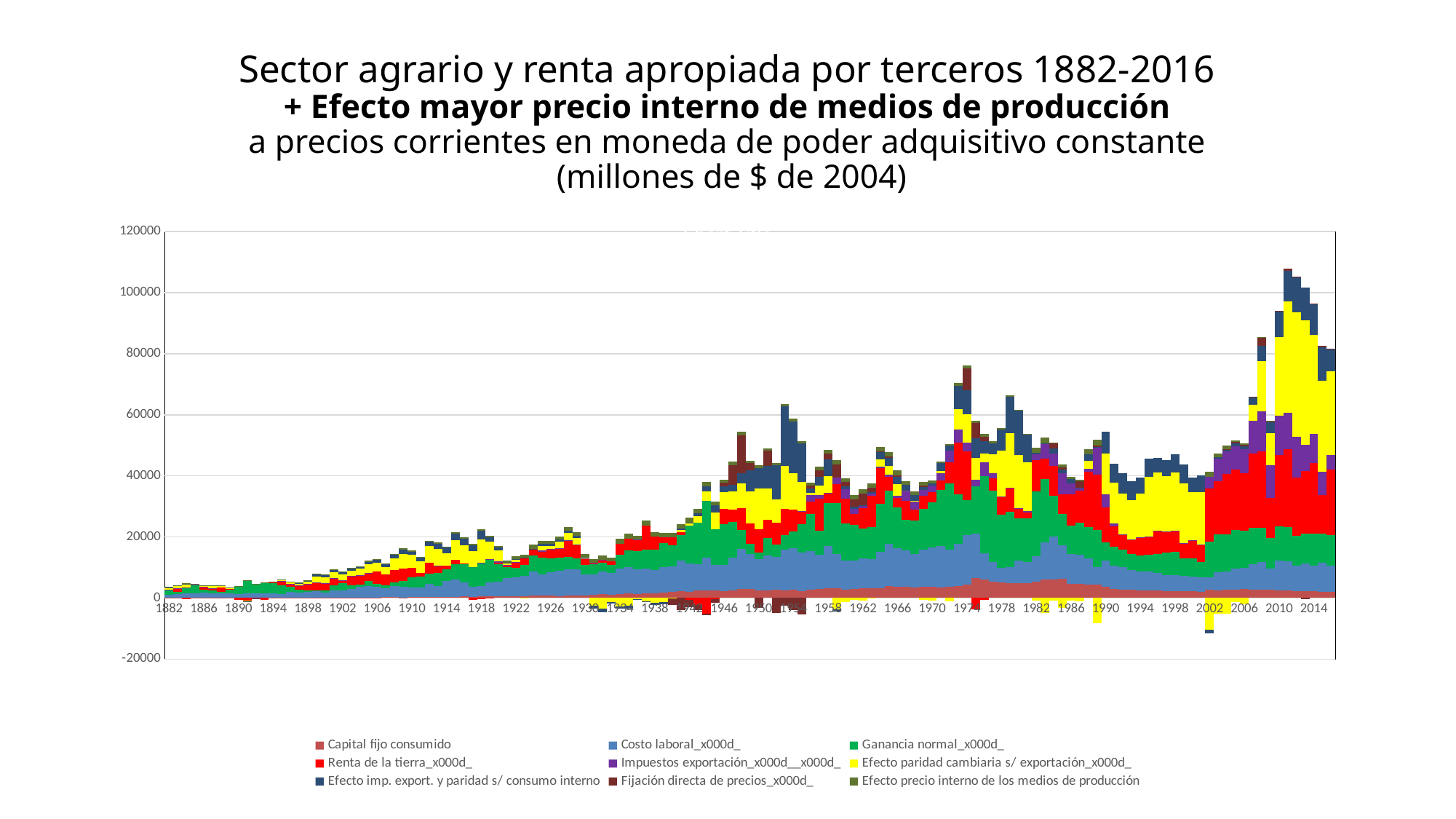
Is the total stacked value for 1974 greater or less than 60000? greater Is the value of the yellow series (Efecto paridad cambiaria s/ exportación) around 2002 greater or less than 0? less Which of the two years has the larger total stacked value, 1918 or 1978? 1978 Is the total stacked value for 1994 greater or less than 20000? greater What is the highest value labelled on the y axis? 120000 What kind of chart is shown on the slide? Stacked bar chart How many series does the legend list? 9 What is the first year shown on the x axis? 1882 Overall, do the stacked totals rise or fall from 1882 to 2016? rise